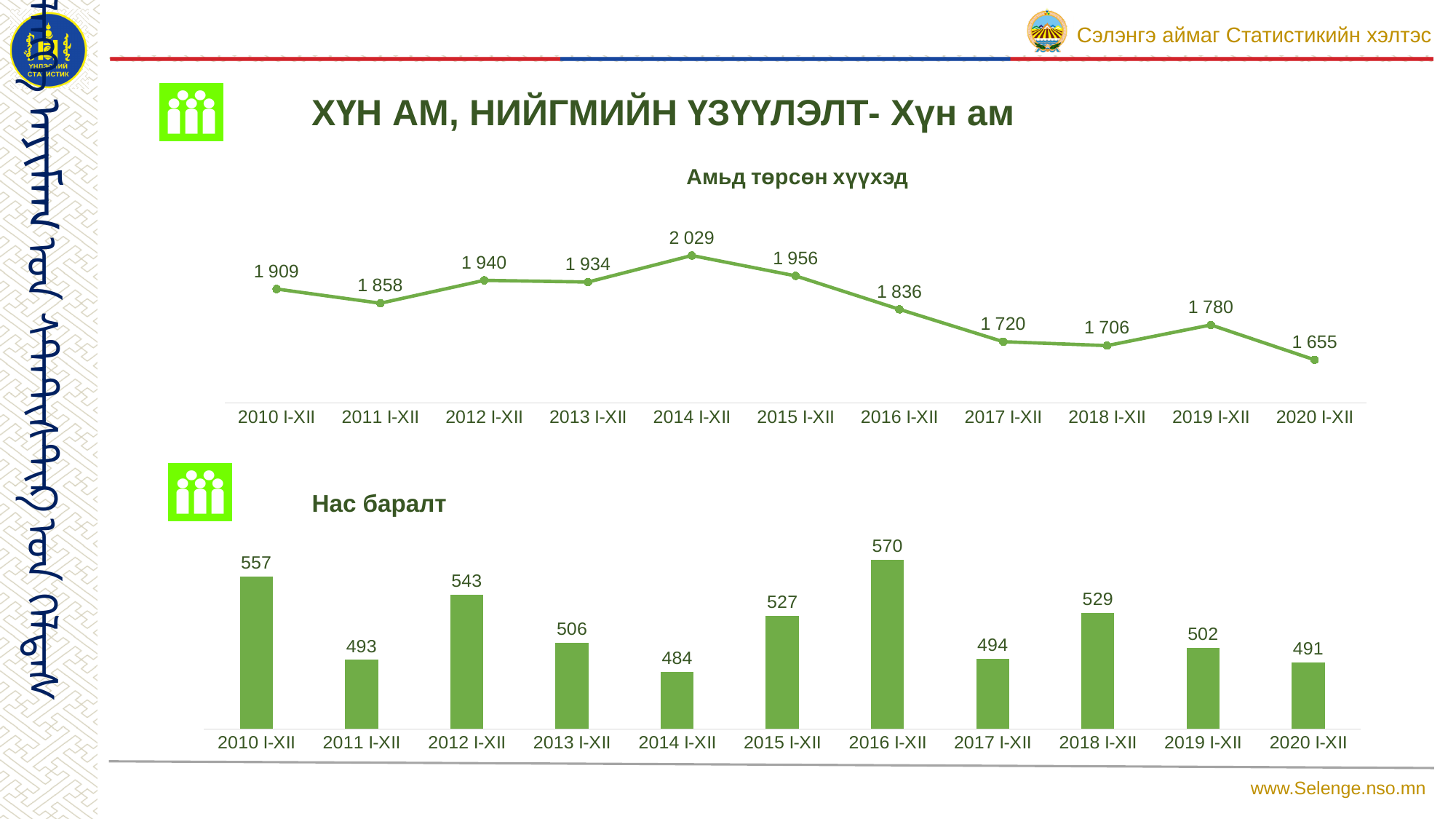
In the 'Амьд төрсөн хүүхэд' chart, do the values rise or fall from 2015 I-XII to 2018 I-XII? fall In the 'Нас баралт' chart, what is the value for 2016 I-XII? 570 In the 'Амьд төрсөн хүүхэд' chart, what is the value for 2014 I-XII? 2 029 In the 'Амьд төрсөн хүүхэд' chart, how many data points are plotted? 11 In the 'Нас баралт' chart, what is the difference between the values for 2010 I-XII and 2011 I-XII? 64 In the 'Амьд төрсөн хүүхэд' chart, which is larger: the value for 2012 I-XII or 2013 I-XII? 2012 I-XII In the 'Амьд төрсөн хүүхэд' chart, what is the difference between the values for 2014 I-XII and 2020 I-XII? 374 In the 'Нас баралт' chart, which is larger: the value for 2018 I-XII or 2019 I-XII? 2018 I-XII What kind of chart is the 'Амьд төрсөн хүүхэд' chart? line chart In the 'Амьд төрсөн хүүхэд' chart, which year has the lowest value? 2020 I-XII What kind of chart is the 'Нас баралт' chart? bar chart In the 'Нас баралт' chart, which year has the lowest value? 2014 I-XII